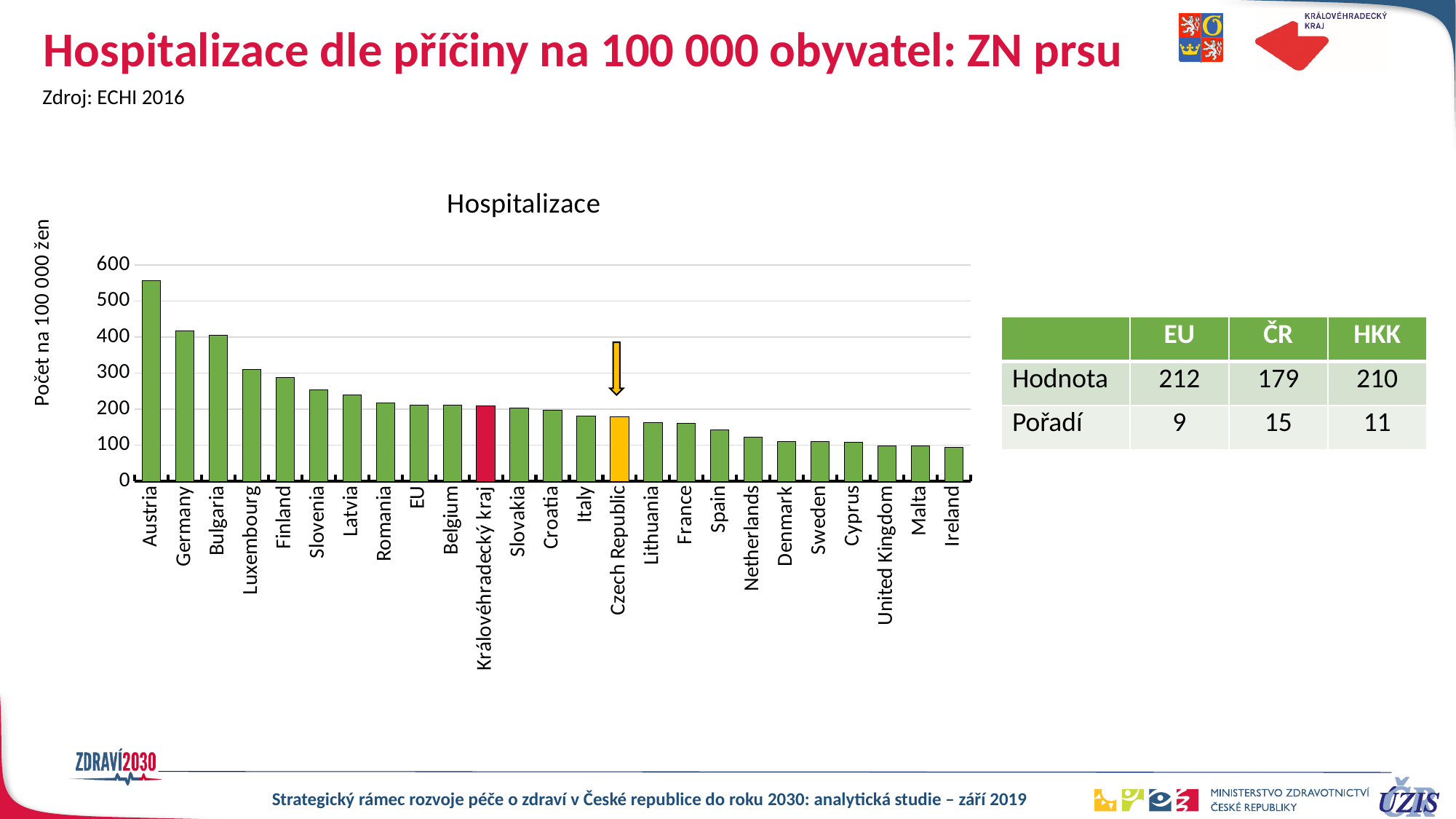
What is the label of the vertical axis? Počet na 100 000 žen Which is larger, the value for Germany or the value for Luxembourg? Germany How many categories (bars) are plotted in the chart? 25 What is the value for the EU? 212 Which category has the highest value in the chart? Austria What is the value for Královéhradecký kraj? 210 Do the values rise or fall from left to right along the x axis? fall What type of chart is shown on the slide? bar chart Is the value for Austria greater or less than 500? greater What is the value for the Czech Republic? 179 What is the difference between the EU value and the Czech Republic value? 33 What is the title of the chart? Hospitalizace